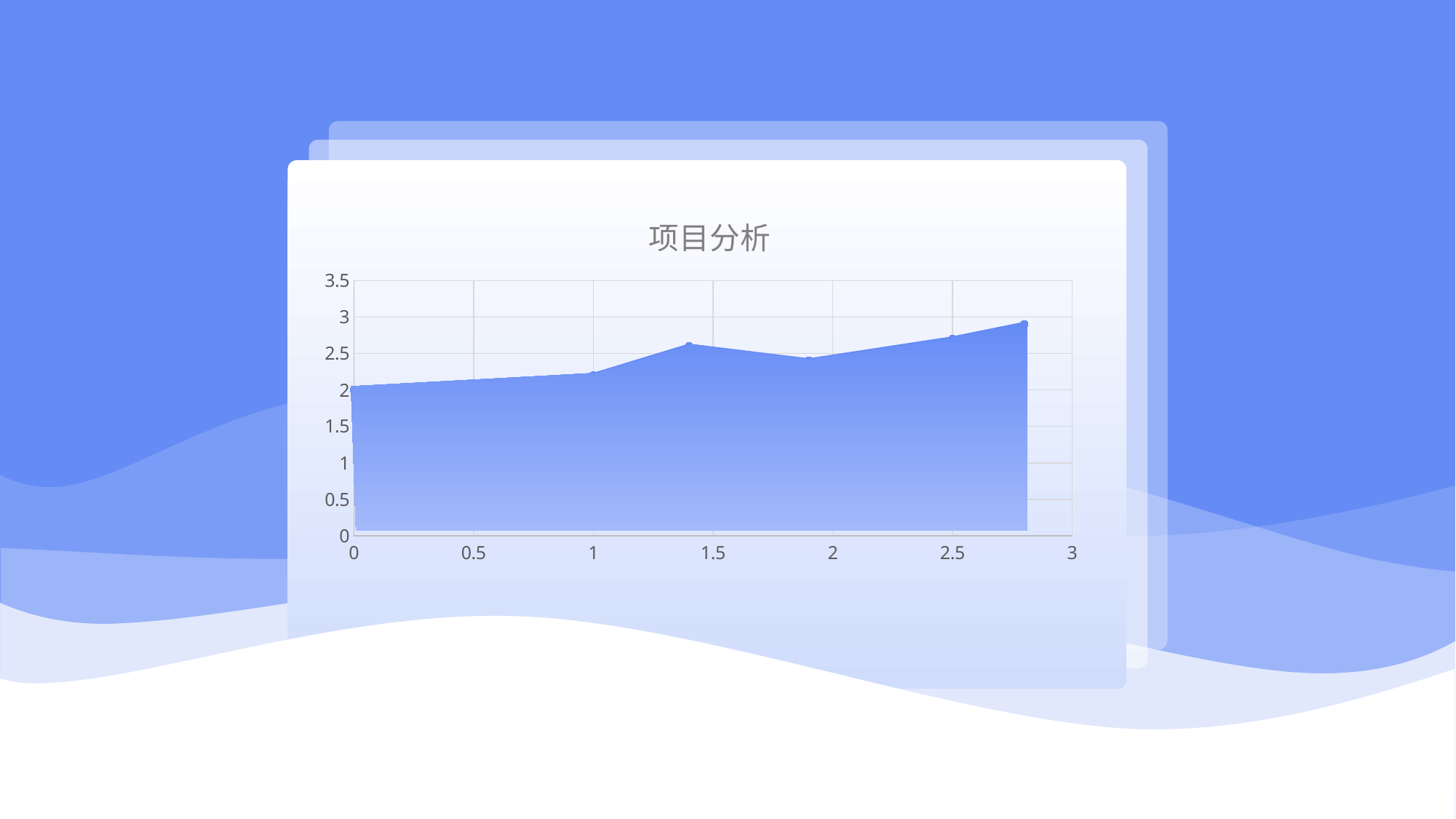
Is the value at x = 2.5 greater or less than 2.5? greater Is the value at x = 1 greater or less than 2? greater Do the values generally rise or fall from left to right along the x axis? Rise At which x value does the chart have its lowest point? 0 Is the value at x = 1.4 greater or less than 2.5? greater What is the title of the chart? 项目分析 How many data points are plotted on the chart? 6 At which x value does the chart reach its highest point? 2.8 Which is larger, the value at x = 1.4 or the value at x = 1.9? x = 1.4 What kind of chart is shown on the slide? Area chart